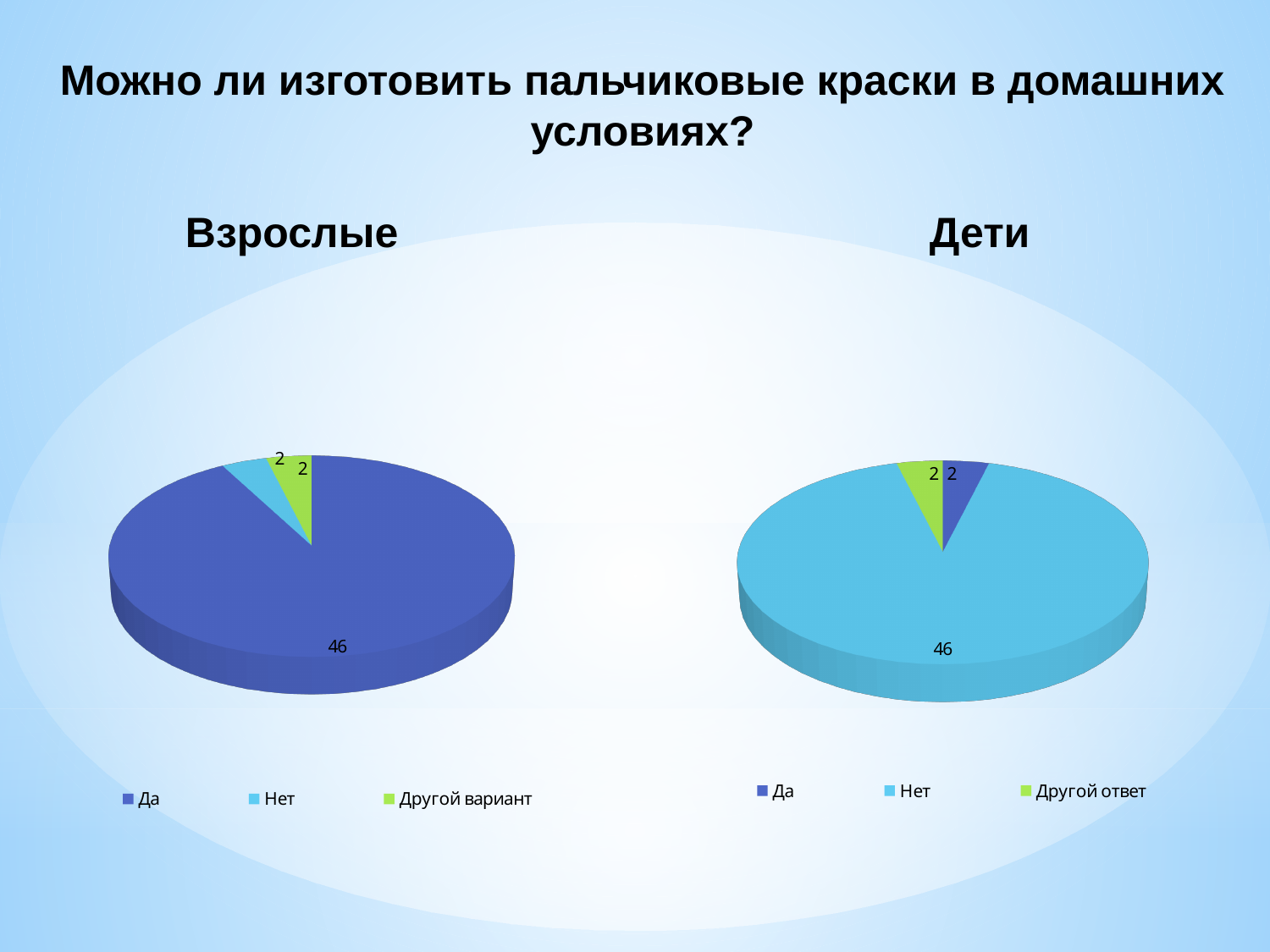
In the "Дети" chart, what is the value for "Да"? 2 What kind of chart is the "Взрослые" chart? Pie chart In the "Дети" chart, which category has the largest slice? Нет How many entries does the legend of the "Дети" chart list? 3 What is the third legend entry in the "Дети" chart? Другой ответ In the "Взрослые" chart, which category has the largest slice? Да In the "Дети" chart, what share of the total does the "Нет" slice represent? 92% In the "Взрослые" chart, what is the value for "Да"? 46 In the "Дети" chart, which is larger, the value for "Да" or the value for "Нет"? Нет In the "Дети" chart, what is the value for "Нет"? 46 How many slices does the "Взрослые" pie chart have? 3 In the "Взрослые" chart, what is the difference between the values for "Да" and "Нет"? 44